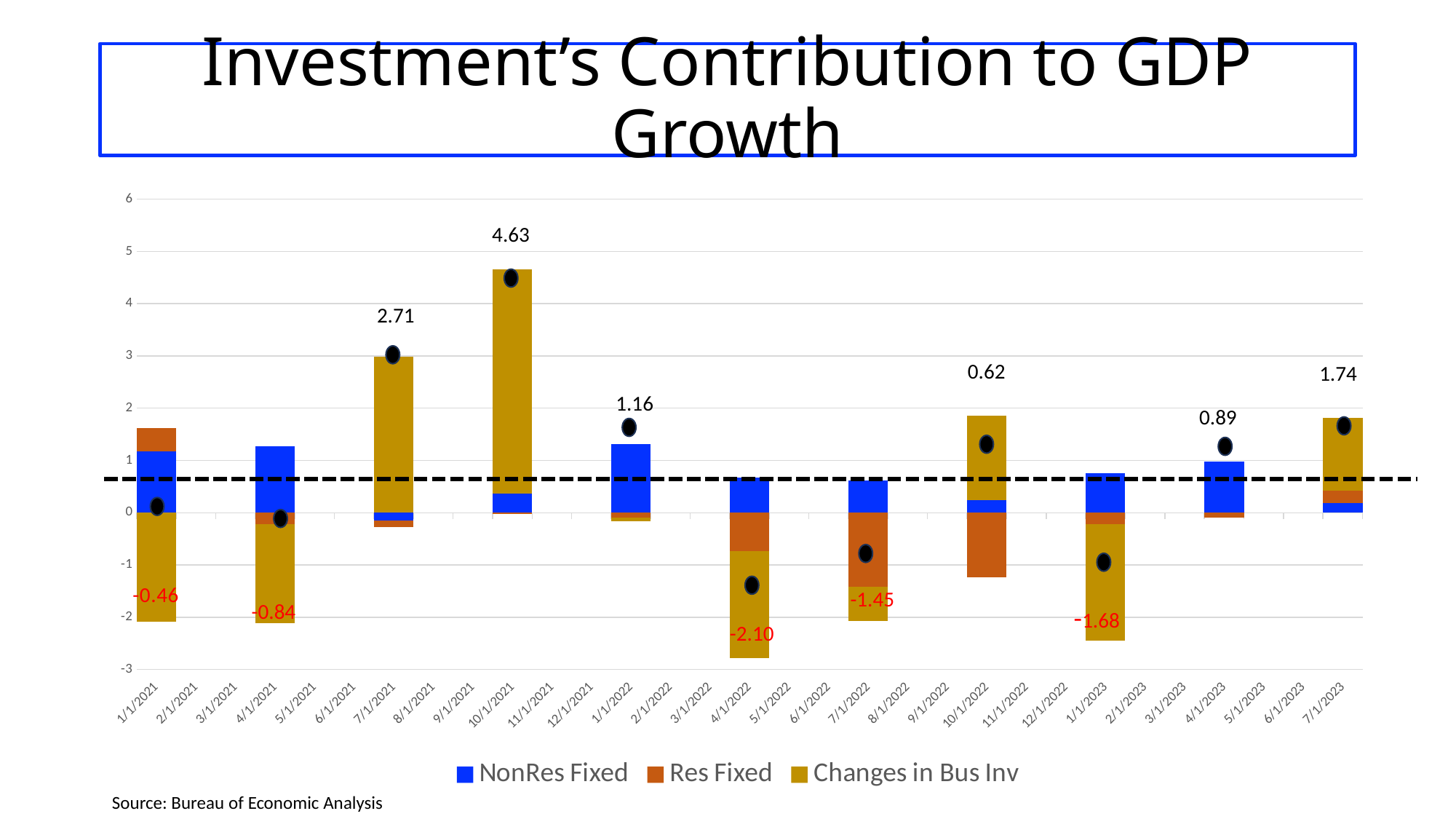
How many quarters have stacked bars plotted on the chart? 11 What is the labeled value for 4/1/2022? -2.10 What is the difference between the labeled values for 10/1/2021 and 7/1/2021? 1.92 Which quarter has the highest labeled total value? 10/1/2021 Which is larger, the labeled value for 4/1/2023 or for 10/1/2022? 4/1/2023 What is the labeled total investment contribution for 10/1/2021? 4.63 What is the labeled value for 1/1/2021? -0.46 What kind of chart is shown on the slide? Stacked bar chart What is the labeled value for 7/1/2023? 1.74 How many series does the legend list? 3 Which quarter has the lowest labeled total value? 4/1/2022 Is the Changes in Bus Inv segment for 7/1/2021 greater or less than 2? greater